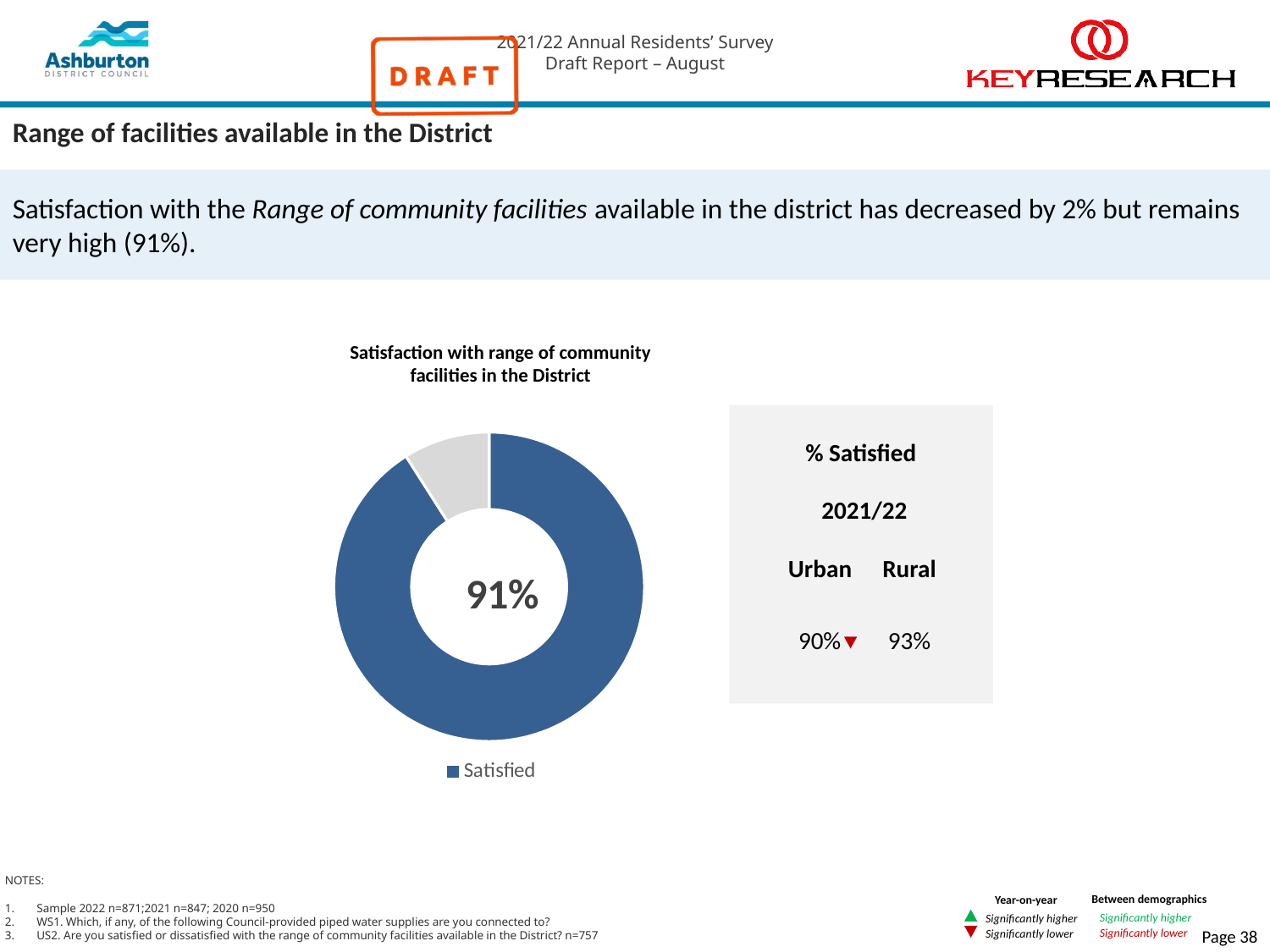
How many slices does the donut chart have? 2 What kind of chart is shown on the slide? pie chart (donut) In the % Satisfied panel, which group has the higher 2021/22 value, Urban or Rural? Rural In the % Satisfied panel next to the chart, what is the 2021/22 value for Rural? 93% How many entries does the legend of the donut chart list? 1 In the % Satisfied panel, what is the difference between the Rural and Urban 2021/22 values? 3% What is the title of the donut chart? Satisfaction with range of community facilities in the District In the % Satisfied panel next to the chart, what is the 2021/22 value for Urban? 90% What is the value shown for Satisfied in the donut chart? 91% What share of the donut chart does the Satisfied slice represent? 91% What is the legend entry shown below the donut chart? Satisfied Which slice of the donut chart is larger, the blue Satisfied slice or the grey slice? the blue Satisfied slice